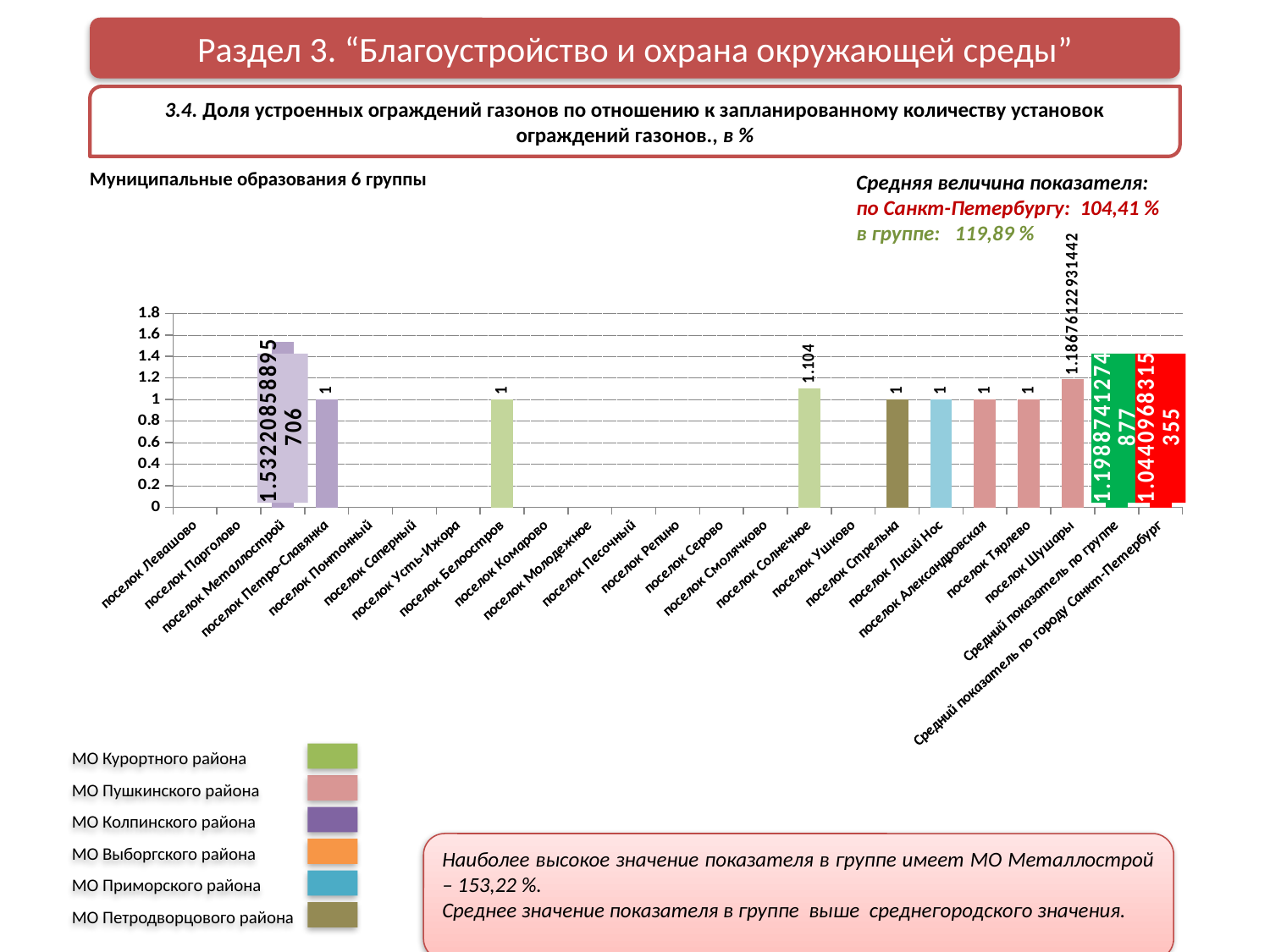
What is the value shown for поселок Шушары? 1.18676122931442 Which district group does the legend associate with the purple colour? МО Колпинского района Is the value for поселок Металлострой greater or less than 1.4? greater What is the value shown for поселок Солнечное? 1.104 Which category has the highest bar in the chart? поселок Металлострой How many district groups are listed in the colour legend below the chart? 6 Which is larger, the value for поселок Шушары or the value for поселок Солнечное? поселок Шушары What is the value shown for Средний показатель по городу Санкт-Петербург? 1.0440968315355 What kind of chart is shown on the slide? bar chart What is the difference between the value for поселок Солнечное and the value for поселок Тярлево? 0.104 How many categories are listed along the x axis of the chart? 23 What is the value shown for поселок Петро-Славянка? 1